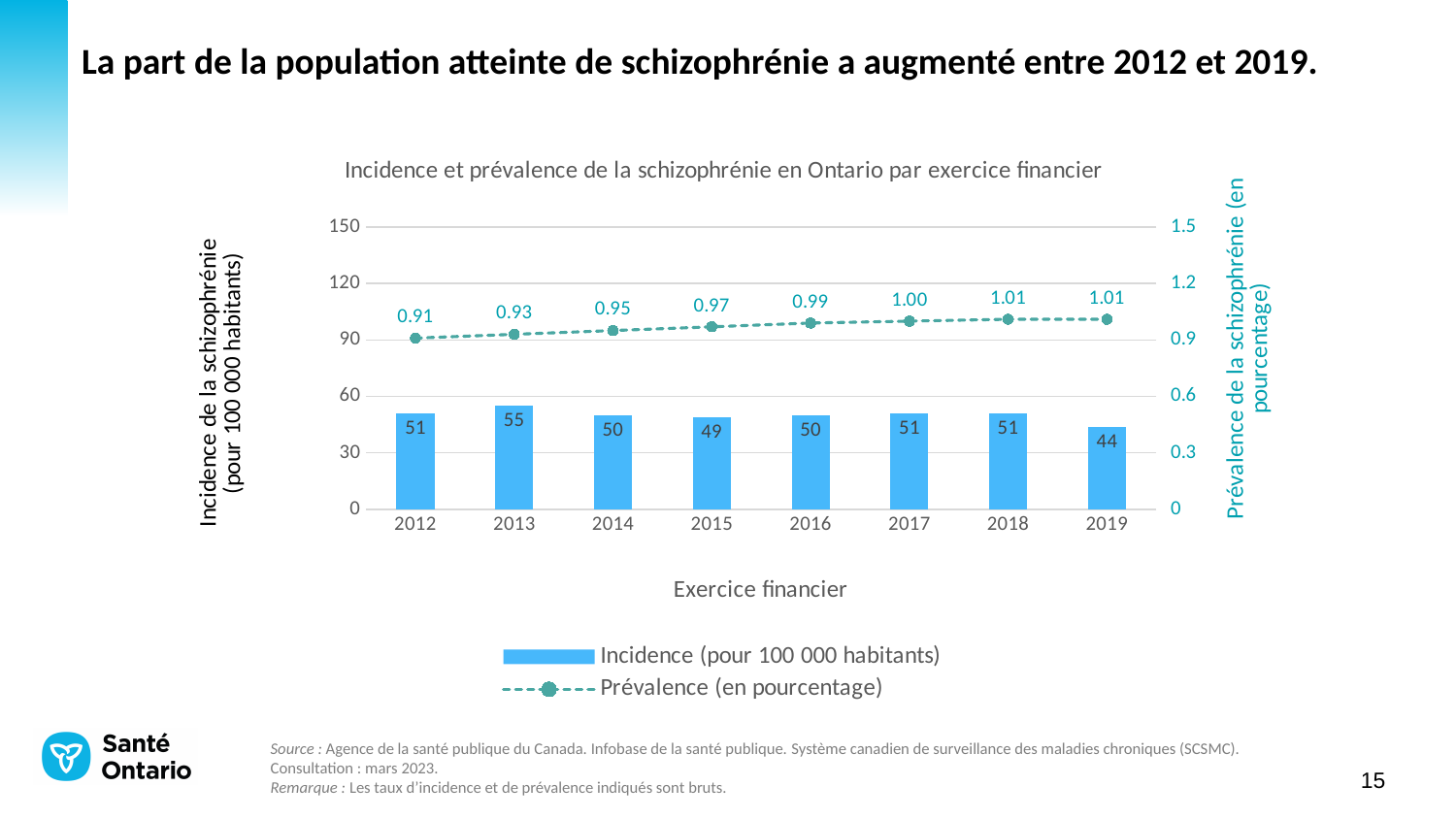
What is the incidence value (pour 100 000 habitants) for 2013? 55 Which year has the lowest incidence value? 2019 What is the difference between the incidence values for 2013 and 2019? 11 Which year has the highest incidence value? 2013 Is the incidence value for 2013 greater or less than 60? less What is the prévalence (en pourcentage) value for 2015? 0.97 Does the prévalence series rise or fall from 2012 to 2019? rise What is the prévalence value for 2019? 1.01 What is the title of the chart? Incidence et prévalence de la schizophrénie en Ontario par exercice financier How many series does the legend list? 2 How many fiscal years are shown on the x axis? 8 Which is larger, the incidence value for 2014 or for 2017? 2017